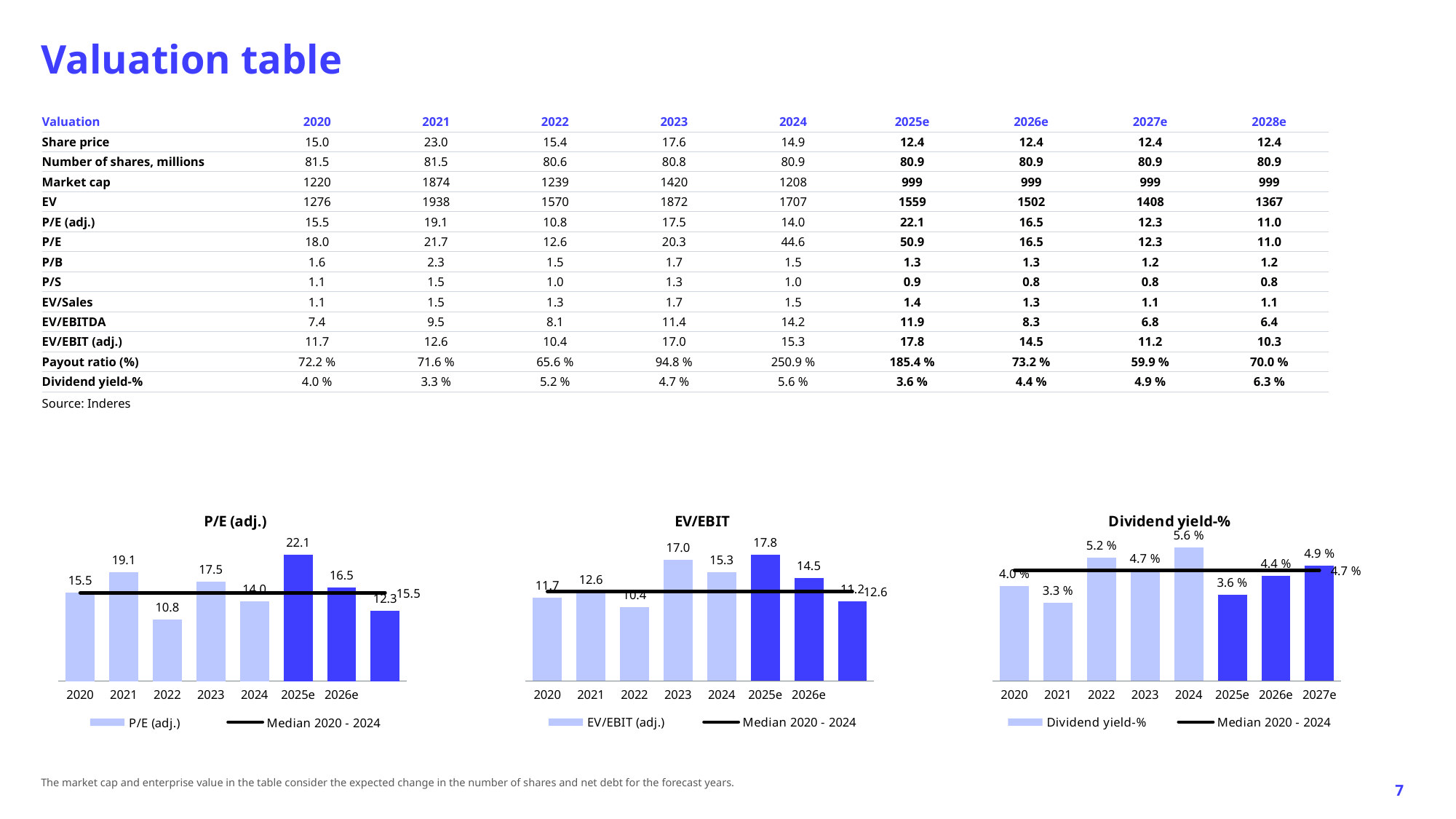
What kind of chart is the Dividend yield-% chart? combination bar and line chart How many years are shown on the x axis of the Dividend yield-% chart? 8 In the EV/EBIT chart, what is the value of the Median 2020 - 2024 line? 12.6 In the EV/EBIT chart, what is the value for 2023? 17.0 In the P/E (adj.) chart, what is the difference between the 2025e value and the 2024 value? 8.1 In the P/E (adj.) chart, what is the value for 2025e? 22.1 In the P/E (adj.) chart, what is the value of the Median 2020 - 2024 line? 15.5 In the Dividend yield-% chart, what is the value for 2027e? 4.9 % In the EV/EBIT chart, is the value for 2024 larger or smaller than the value for 2026e? larger In the Dividend yield-% chart, which year has the highest value? 2024 In the EV/EBIT chart, which year has the highest value? 2025e In the P/E (adj.) chart, which year has the lowest value? 2022